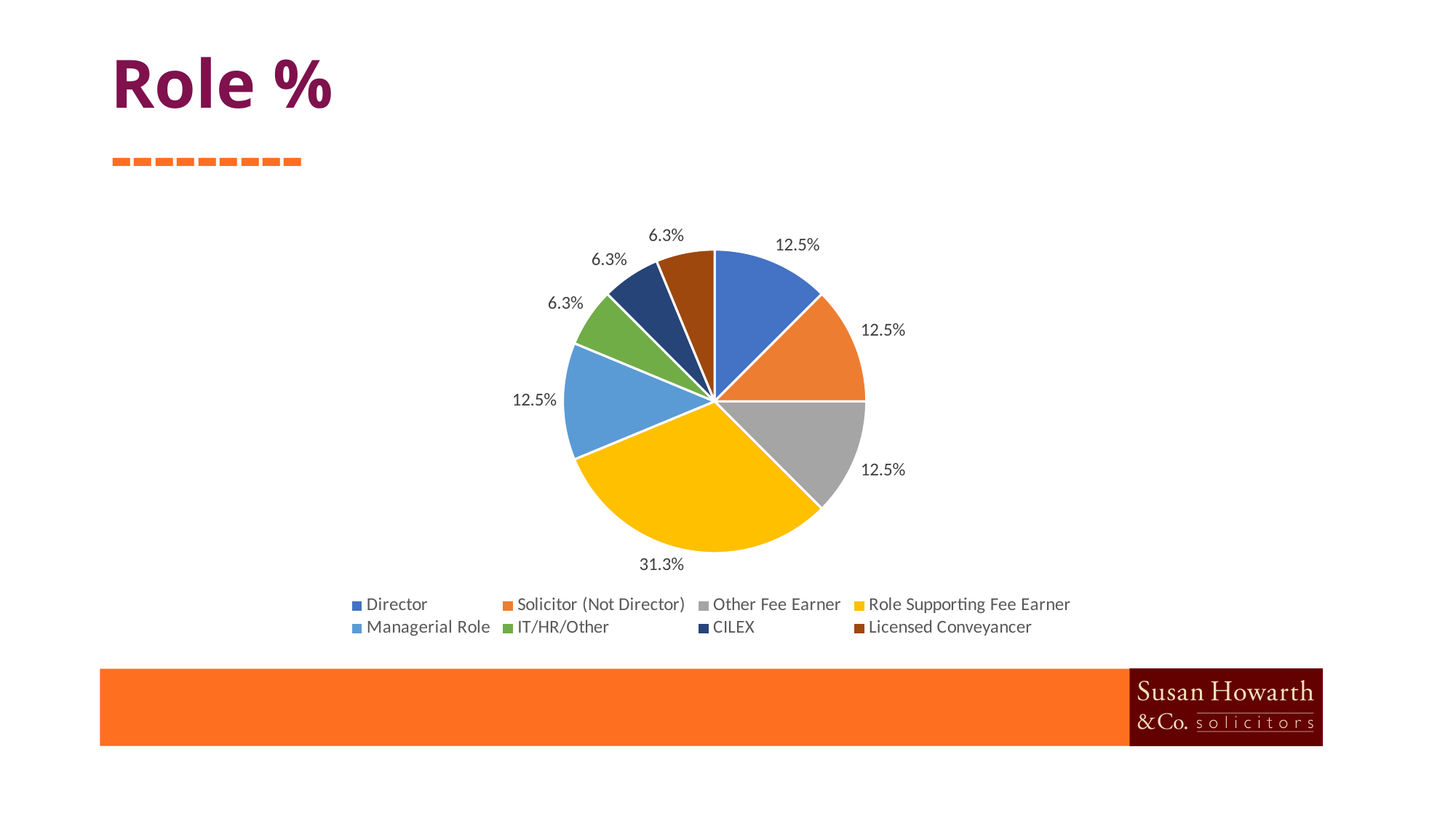
What share of the pie is Role Supporting Fee Earner? 31.3% Which is larger, Other Fee Earner or IT/HR/Other? Other Fee Earner What colour is the Role Supporting Fee Earner slice? Yellow What is the value for CILEX? 6.3% What kind of chart is shown on the slide? Pie chart What is the value for Director? 12.5% What is the value for Licensed Conveyancer? 6.3% Which category has the largest slice? Role Supporting Fee Earner How many categories does the legend list? 8 What is the title of the chart? Role % What is the difference between Role Supporting Fee Earner and Solicitor (Not Director)? 18.8% What is the value for Managerial Role? 12.5%